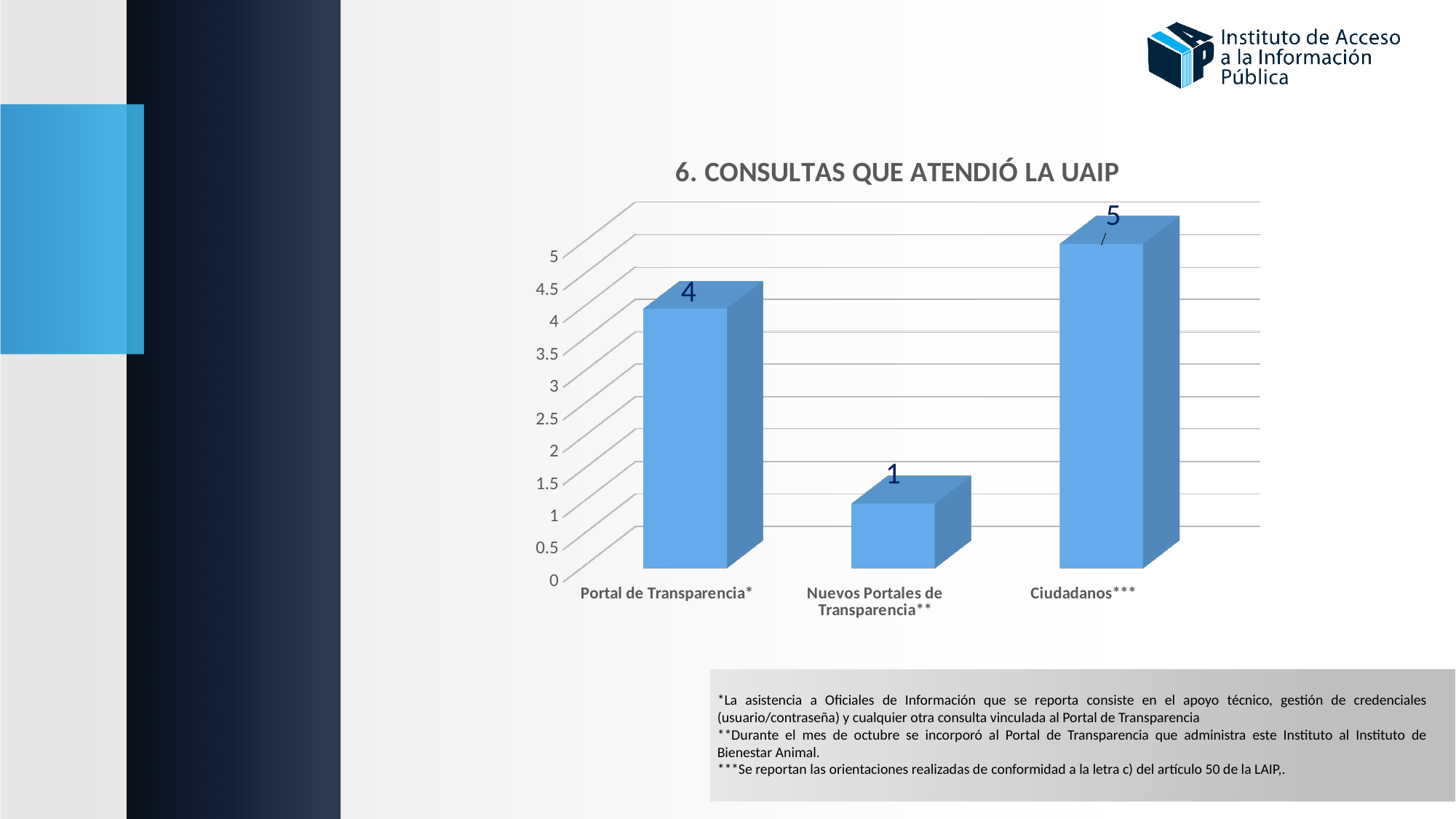
Which is larger, the value for Portal de Transparencia* or the value for Nuevos Portales de Transparencia**? Portal de Transparencia* What is the value for Portal de Transparencia*? 4 Is the value for Ciudadanos*** greater or less than 3? greater What kind of chart is shown on the slide? bar chart How many categories are shown on the x axis? 3 Which category has the lowest value? Nuevos Portales de Transparencia** What is the title of the chart? 6. CONSULTAS QUE ATENDIÓ LA UAIP What is the difference between the values for Ciudadanos*** and Portal de Transparencia*? 1 What is the value for Nuevos Portales de Transparencia**? 1 Which category has the highest value? Ciudadanos*** What is the difference between the values for Portal de Transparencia* and Nuevos Portales de Transparencia**? 3 What is the value for Ciudadanos***? 5